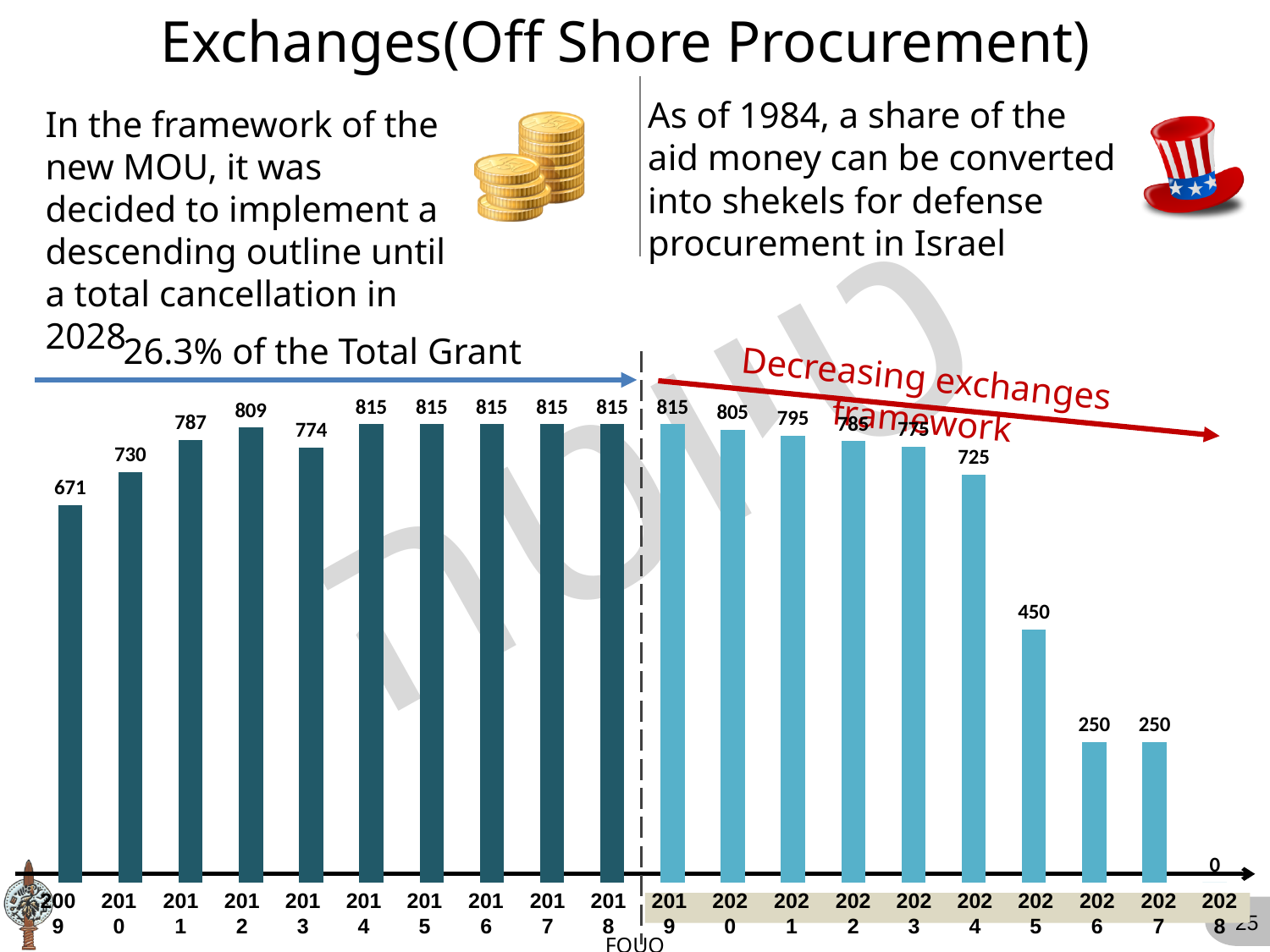
What is the value for 2012? 809 Which is larger, the value for 2012 or the value for 2013? 2012 Which year has the lowest value? 2028 What is the difference between the values for 2010 and 2009? 59 What is the value for 2025? 450 What is the difference between the values for 2025 and 2026? 200 What kind of chart is shown on the slide? bar chart Do the values rise or fall from 2019 to 2028? fall What is the value for 2020? 805 What is the value for 2009? 671 What colour are the bars for the years 2019 to 2028? light blue How many years are shown on the x axis? 20